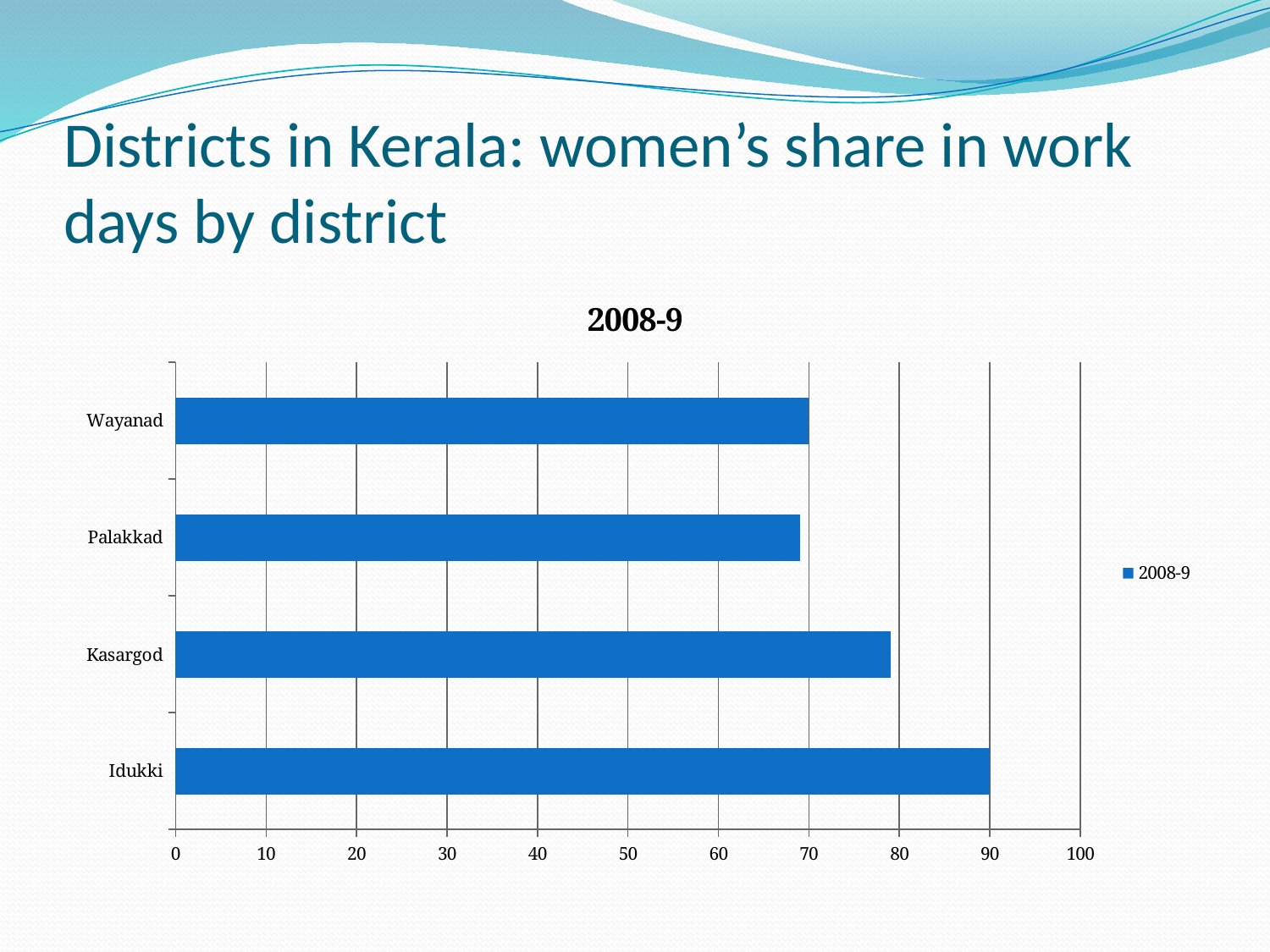
What type of chart is shown on the slide? bar chart How many districts are shown in the chart? 4 What is the value for Wayanad? 70 What is the value for Idukki? 90 Which is larger, the value for Kasargod or the value for Wayanad? Kasargod Is the value for Palakkad greater or less than 70? less Is the value for Kasargod greater or less than 80? less What entry does the legend show? 2008-9 How many series does the legend list? 1 Which district has the highest value in the chart? Idukki What is the title of the chart? 2008-9 Is the value for Kasargod greater or less than 70? greater